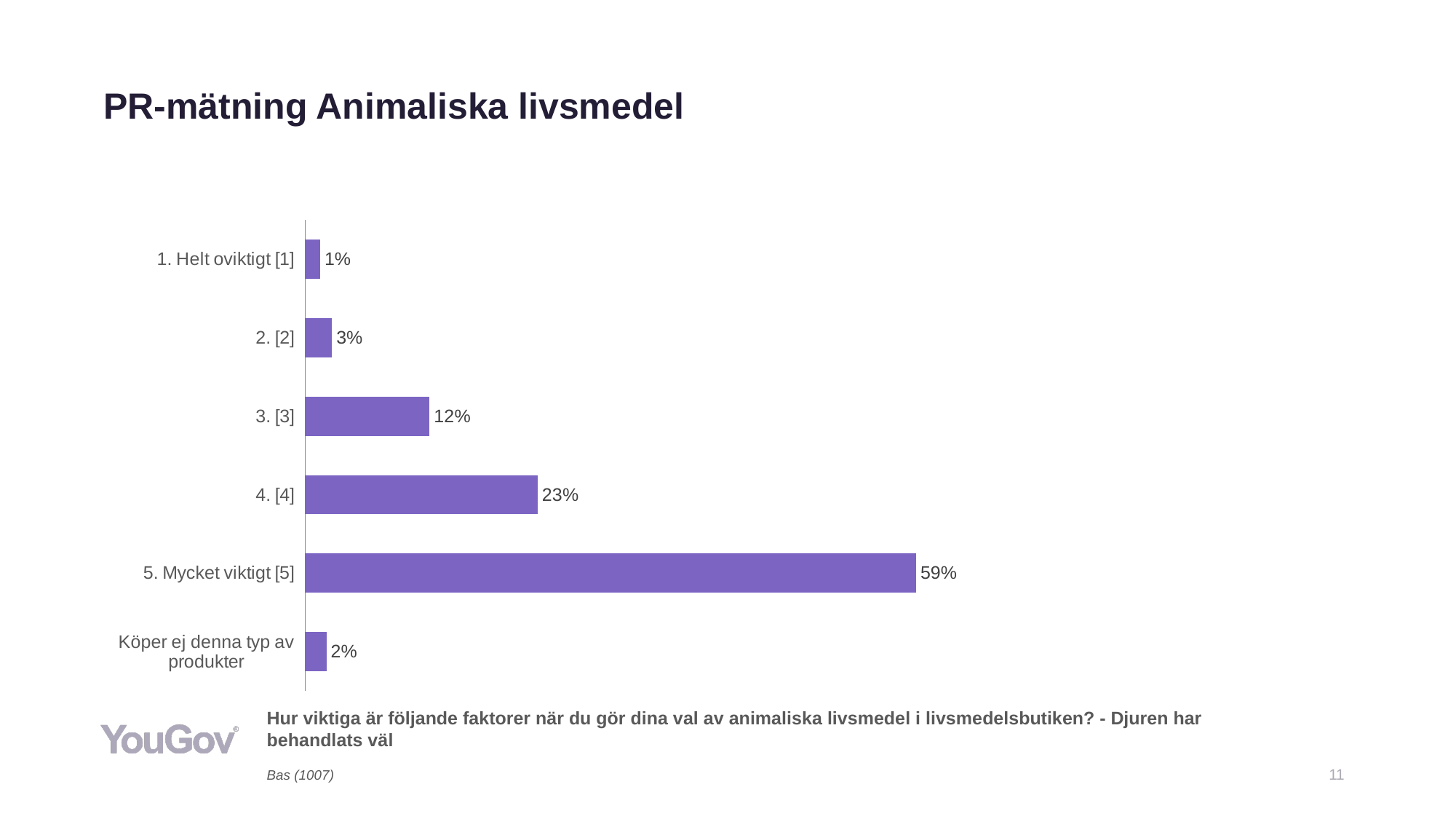
How many categories are shown in the chart? 6 What is the combined value of "4. [4]" and "5. Mycket viktigt [5]"? 82% What is the difference between the values for "5. Mycket viktigt [5]" and "4. [4]"? 36% What is the value for "1. Helt oviktigt [1]"? 1% What kind of chart is shown on the slide? Bar chart What is the base (Bas) sample size shown on the slide? 1007 What is the value for "Köper ej denna typ av produkter"? 2% What percentage of respondents answered "5. Mycket viktigt [5]"? 59% Which category has the highest value? 5. Mycket viktigt [5] What is the value for "3. [3]"? 12% Which category has the lowest value? 1. Helt oviktigt [1] Which is larger, the value for "2. [2]" or the value for "3. [3]"? 3. [3]